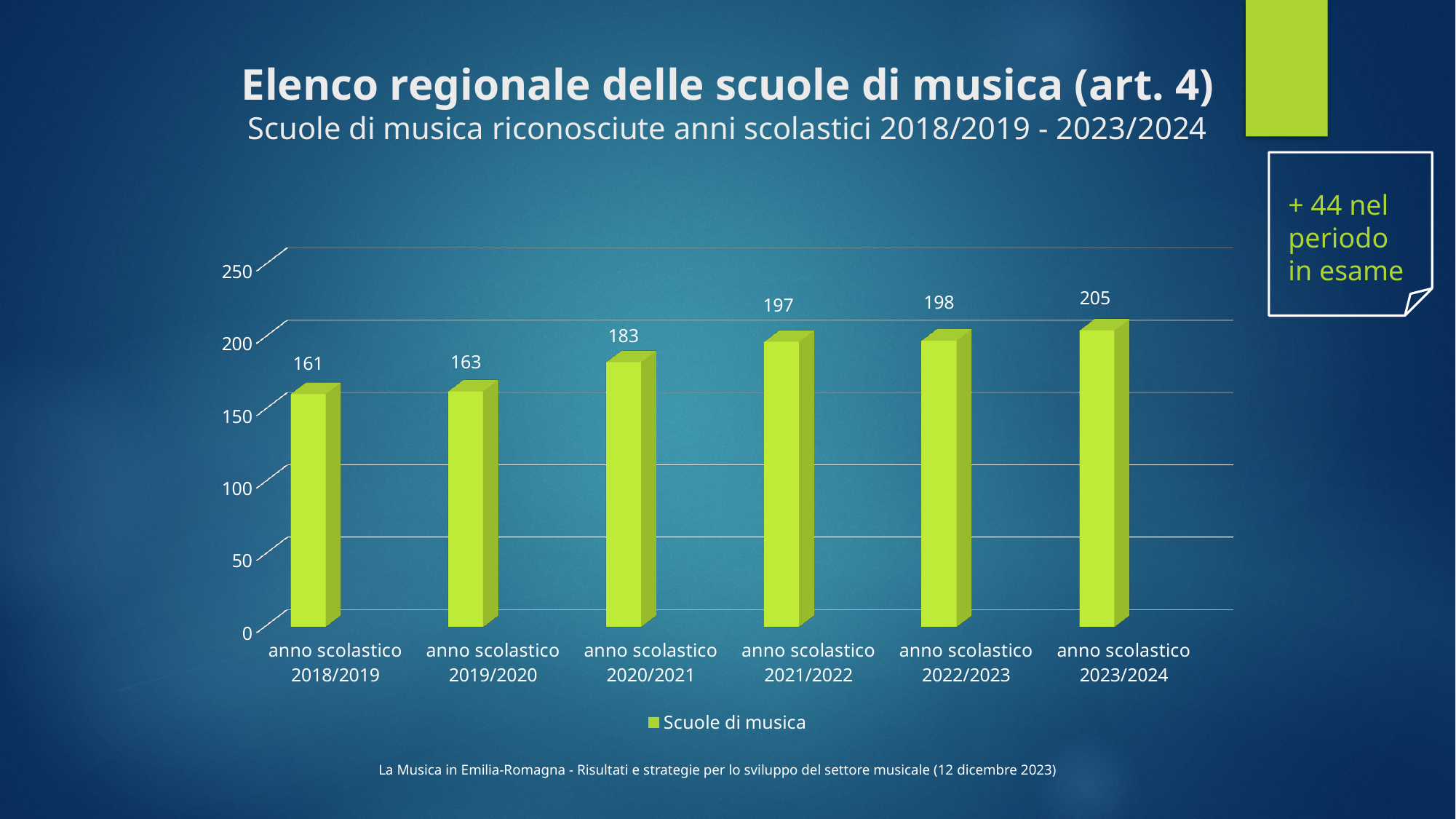
Which is larger, the value for anno scolastico 2019/2020 or anno scolastico 2022/2023? anno scolastico 2022/2023 What is the value for anno scolastico 2020/2021? 183 How many school years are shown on the chart? 6 What is the value for anno scolastico 2018/2019? 161 What kind of chart is shown on the slide? bar chart Which school year has the lowest value? anno scolastico 2018/2019 What is the difference between the values for anno scolastico 2023/2024 and anno scolastico 2018/2019? 44 Which school year has the highest value? anno scolastico 2023/2024 What is the value for anno scolastico 2023/2024? 205 What is the difference between the values for anno scolastico 2021/2022 and anno scolastico 2020/2021? 14 Do the values rise or fall from anno scolastico 2018/2019 to anno scolastico 2023/2024? rise How many series does the legend list? 1